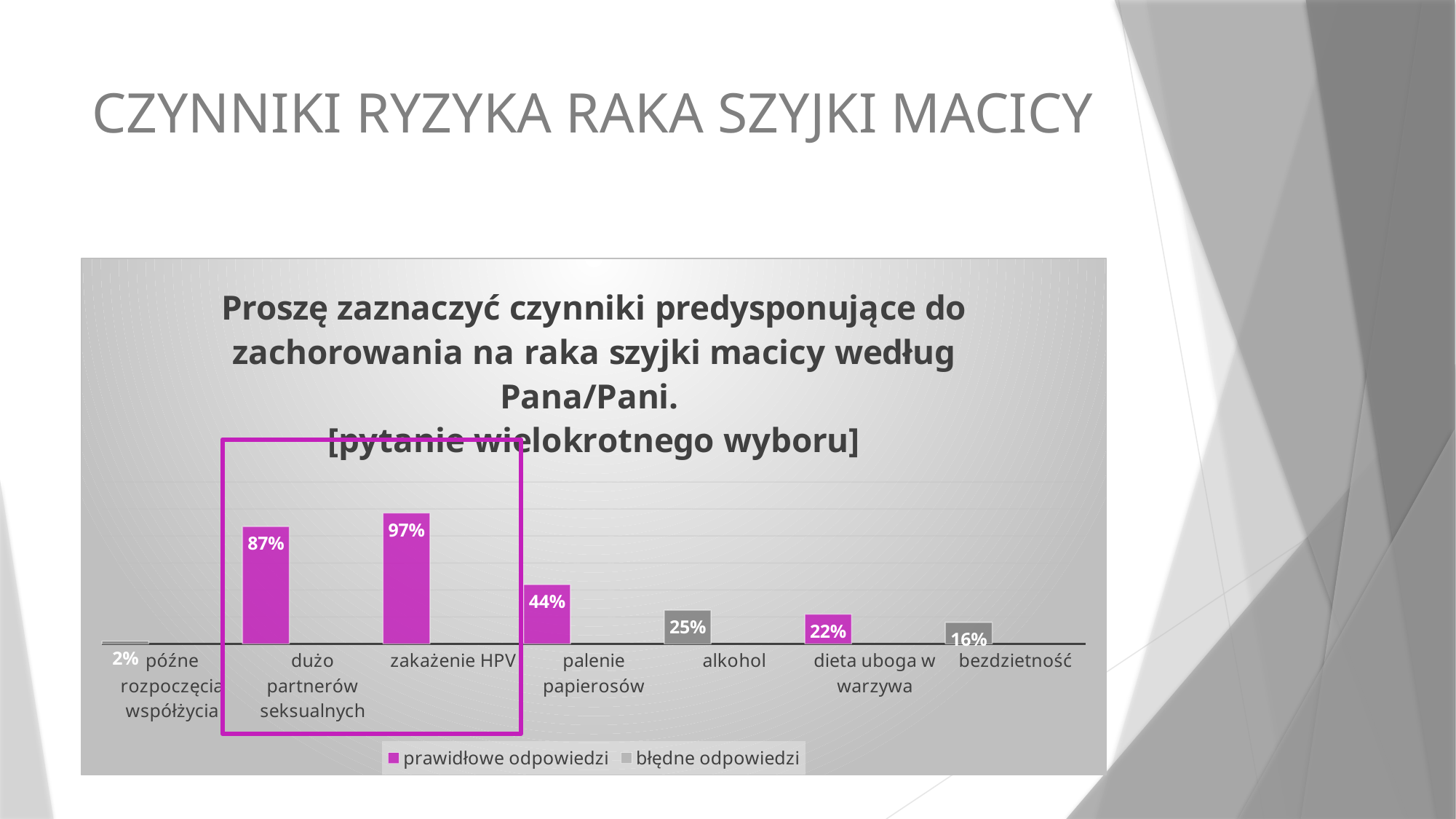
What is the value for bezdzietność? 16% How many series does the legend list? 2 What is the value for alkohol? 25% Which category has the highest value? zakażenie HPV Which category has the lowest value? późne rozpoczęcia współżycia What kind of chart is shown on the slide? bar chart What is the difference between the values for zakażenie HPV and dużo partnerów seksualnych? 10% How many categories are shown on the x axis? 7 What is the value for dużo partnerów seksualnych? 87% What is the value for zakażenie HPV? 97% Which legend entry is shown in magenta? prawidłowe odpowiedzi Which is larger, the value for palenie papierosów or the value for alkohol? palenie papierosów